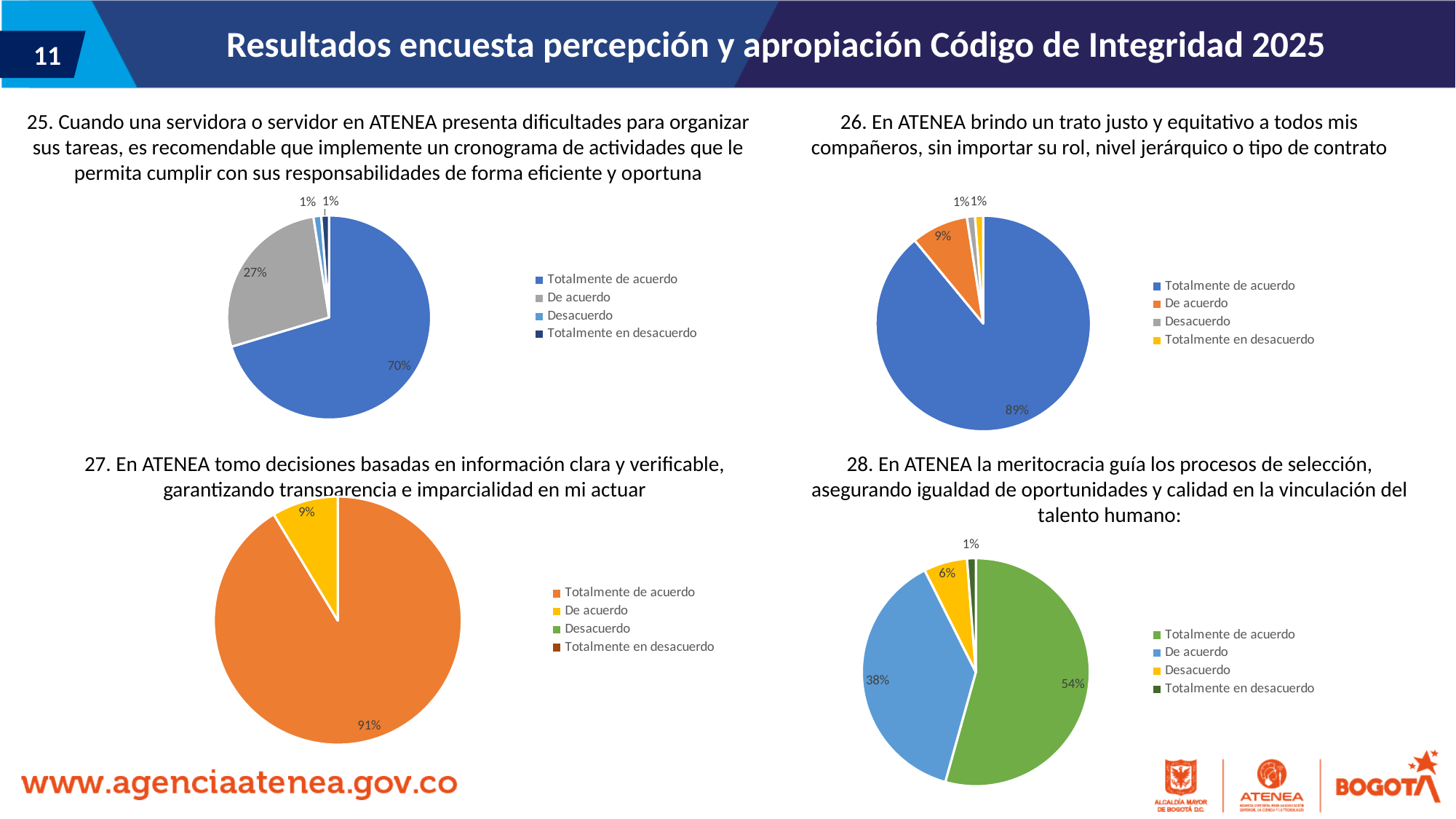
In the bottom-right chart (question 28), what colour represents 'Totalmente de acuerdo'? Green In the top-left chart (question 25), what share of respondents answered 'De acuerdo'? 27% In the bottom-right chart (question 28), which response category has the largest share? Totalmente de acuerdo In the top-left chart (question 25), what share of respondents answered 'Totalmente de acuerdo'? 70% In the top-right chart (question 26), what share of respondents answered 'De acuerdo'? 9% In the top-right chart (question 26), what share of respondents answered 'Totalmente de acuerdo'? 89% In the bottom-left chart (question 27), what share of respondents answered 'Totalmente de acuerdo'? 91% How many entries does the legend of the top-right chart (question 26) list? 4 In the bottom-right chart (question 28), what is the difference between the 'Totalmente de acuerdo' and 'De acuerdo' shares? 16 percentage points What type of chart is used for question 27 (bottom-left)? Pie chart In the bottom-right chart (question 28), what share of respondents answered 'De acuerdo'? 38% In the top-left chart (question 25), which is larger: the 'De acuerdo' share or the 'Desacuerdo' share? De acuerdo